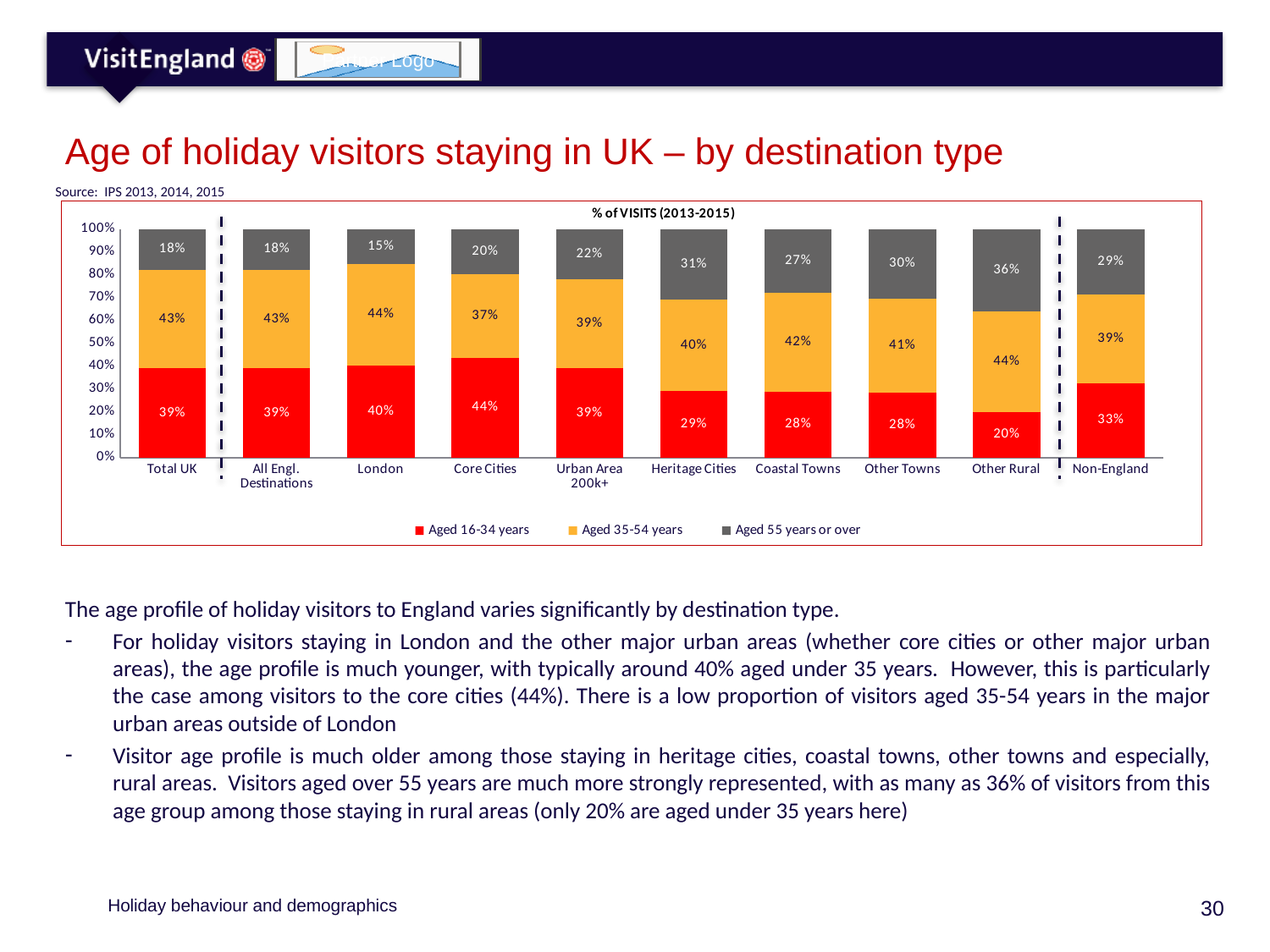
How many age groups does the chart legend list? 3 How many destination types are shown on the x axis of the chart? 10 What percentage of holiday visitors to Other Rural destinations are aged 55 years or over? 36% What percentage of holiday visitors to Core Cities are aged 16-34 years? 44% What is the difference in percentage points between the share of visitors aged 16-34 years in Core Cities and in Other Rural destinations? 24 percentage points Is the share of visitors aged 55 years or over larger for Heritage Cities or for Coastal Towns? Heritage Cities Which colour represents visitors aged 16-34 years in the chart? Red What type of chart is used to show the age of holiday visitors by destination type? Stacked bar chart What percentage of holiday visitors to London are aged 35-54 years? 44% Which destination type has the highest share of visitors aged 55 years or over? Other Rural Which destination type has the lowest share of visitors aged 55 years or over? London Which destination type has the lowest share of visitors aged 16-34 years? Other Rural